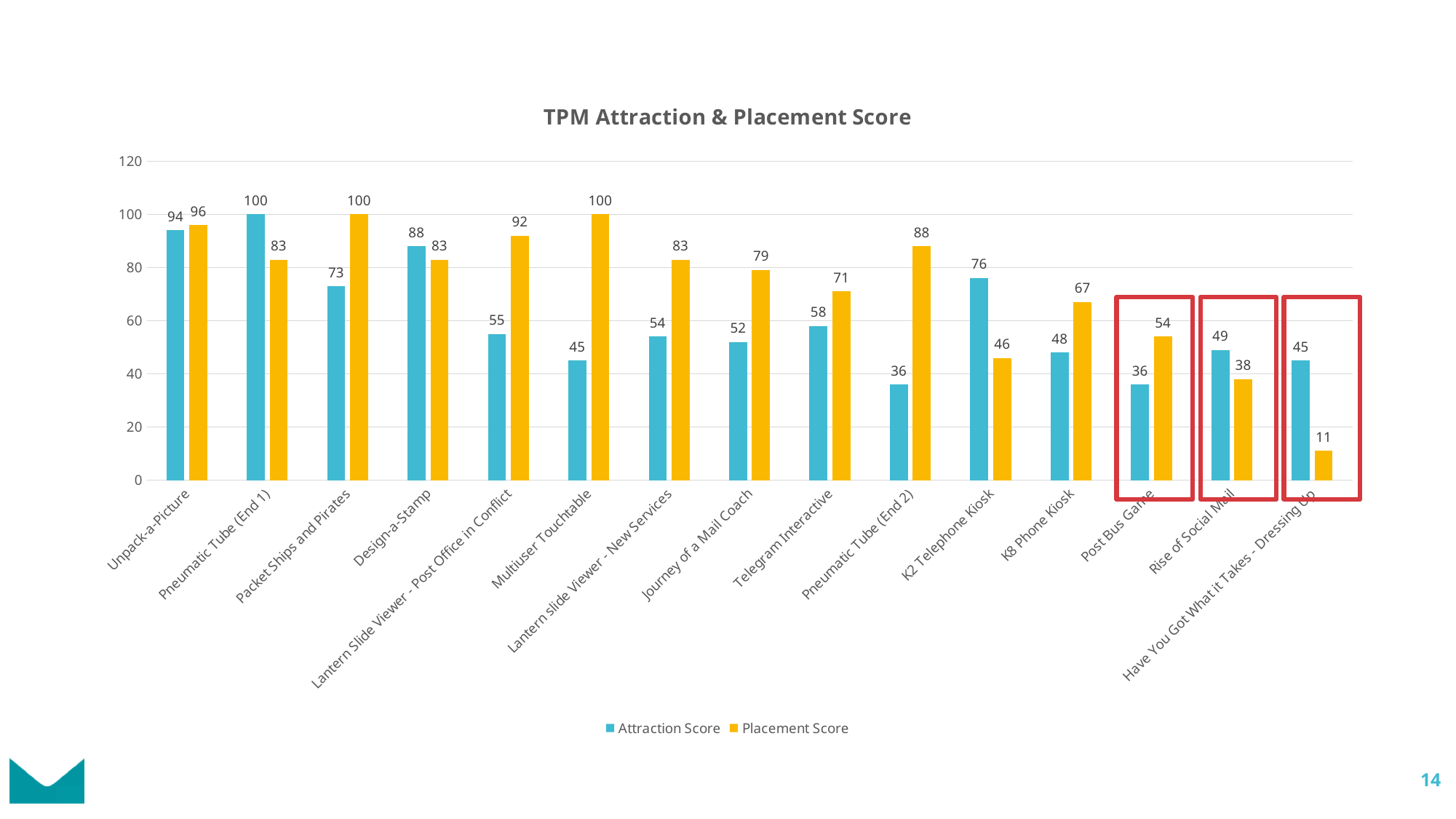
What kind of chart is shown on the slide? Bar chart What is the Placement Score for K2 Telephone Kiosk? 46 Which category has the highest Attraction Score? Pneumatic Tube (End 1) Which category has the lowest Placement Score? Have You Got What it Takes - Dressing Up What is the Attraction Score for Unpack-a-Picture? 94 How many categories are shown on the x axis? 15 What is the difference between the Placement Score and the Attraction Score for Multiuser Touchtable? 55 What is the Placement Score for Pneumatic Tube (End 2)? 88 What is the title of the chart? TPM Attraction & Placement Score Which is larger for Rise of Social Mail, the Attraction Score or the Placement Score? Attraction Score Is the Placement Score for Journey of a Mail Coach greater or less than 60? greater How many series does the legend list? 2